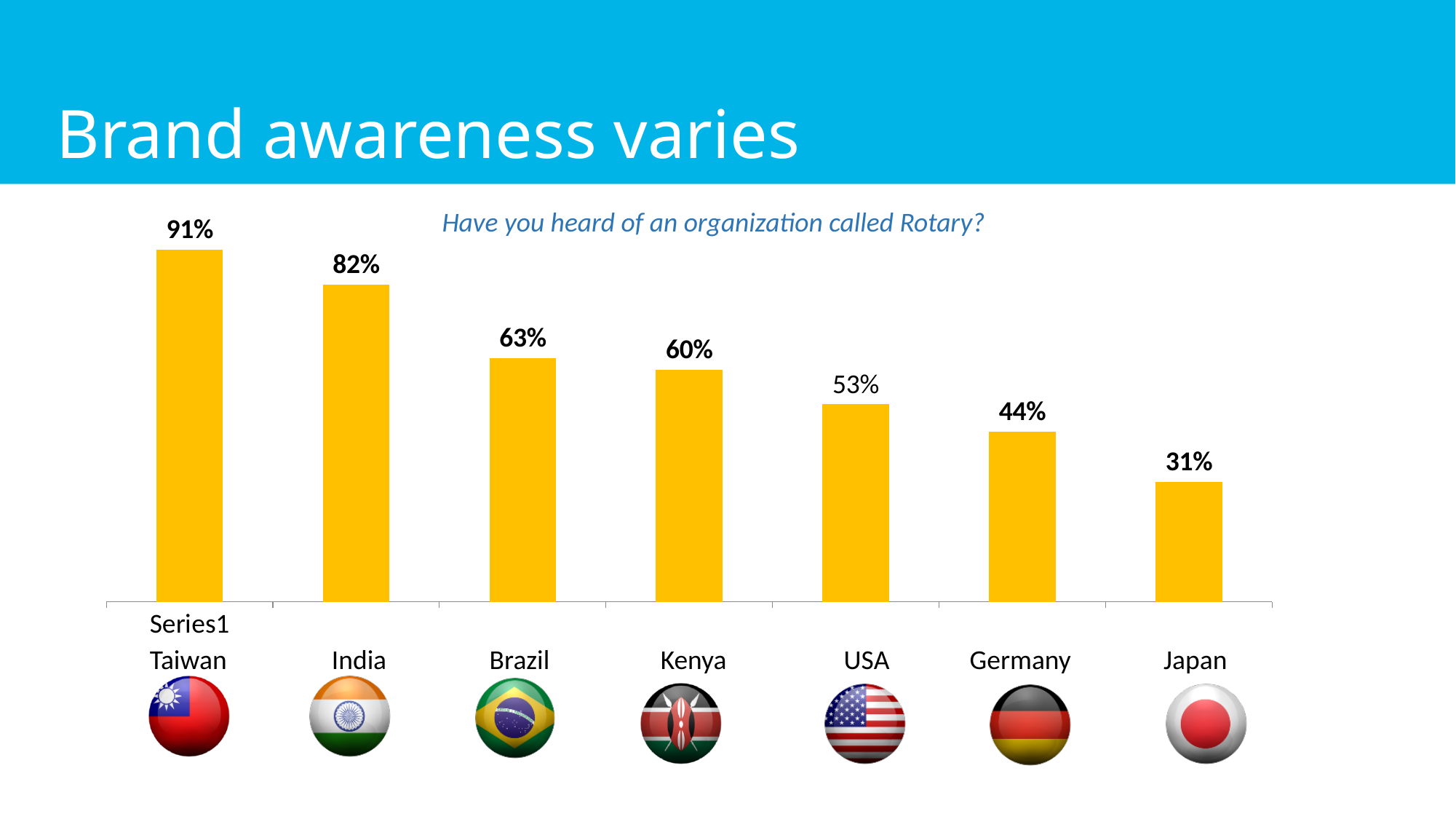
Which country has the lowest brand awareness value? Japan What is the value shown for India? 82% What is the difference between the values for Brazil and Kenya? 3% What is the value shown for Japan? 31% What percentage of respondents in Taiwan have heard of Rotary? 91% Do the values rise or fall from left to right across the countries? Fall What is the difference between the values for Taiwan and Japan? 60% Which has a higher value, Germany or USA? USA How many countries are shown in the chart? 7 What kind of chart is shown on the slide? Bar chart What is the value shown for USA? 53% Which country has the highest brand awareness value? Taiwan